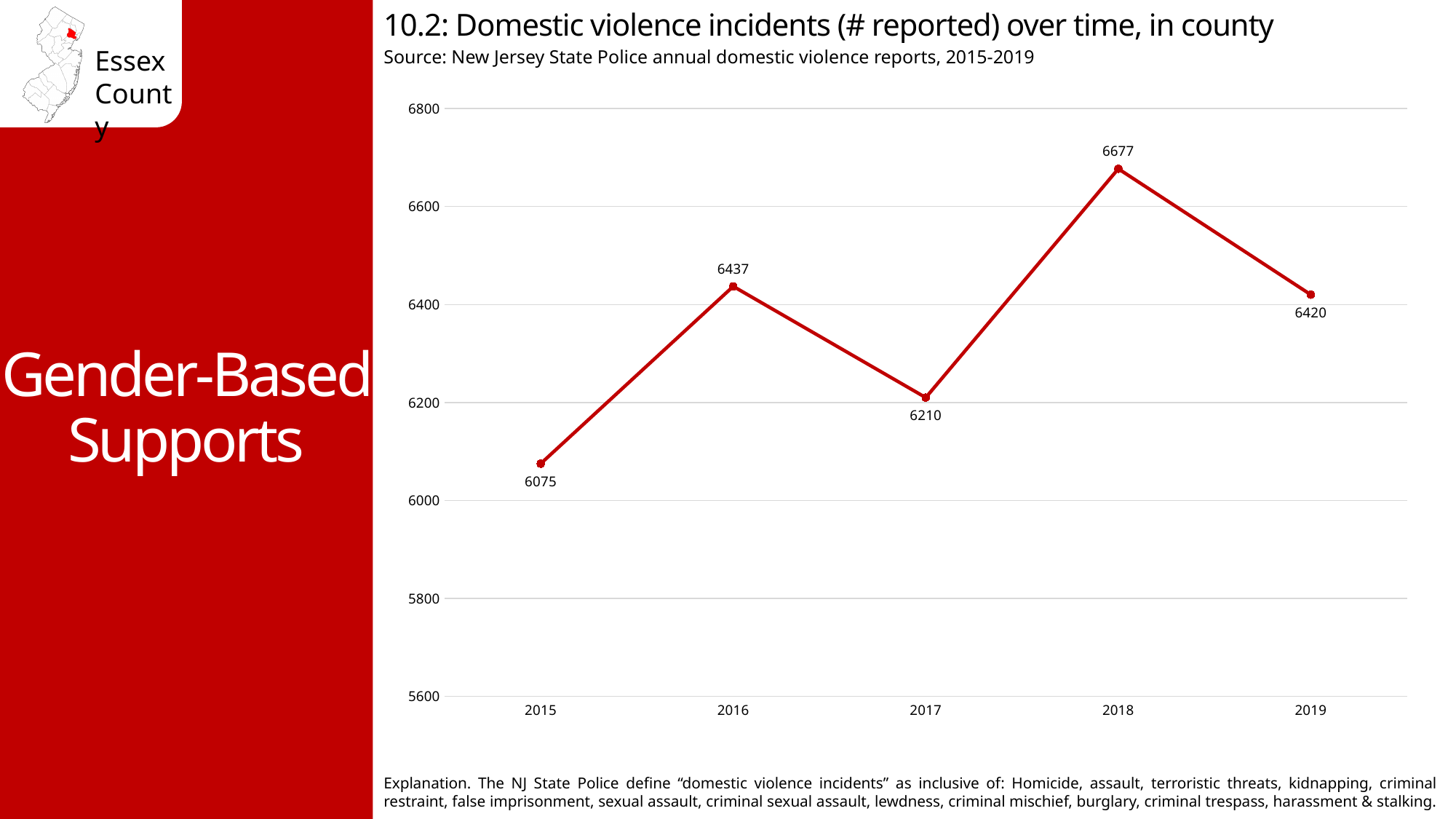
How many years are plotted on the chart? 5 What is the difference in reported incidents between 2018 and 2017? 467 Did the number of reported incidents rise or fall from 2018 to 2019? fall What kind of chart is shown on the slide? line chart Which year had more reported incidents, 2016 or 2019? 2016 What is the difference in reported incidents between 2016 and 2015? 362 Is the value for 2019 greater or less than 6400? greater Which year had the highest number of reported domestic violence incidents? 2018 What was the number of reported domestic violence incidents in 2017? 6210 What was the number of reported domestic violence incidents in 2018? 6677 Which year had the lowest number of reported domestic violence incidents? 2015 What was the number of reported domestic violence incidents in 2015? 6075